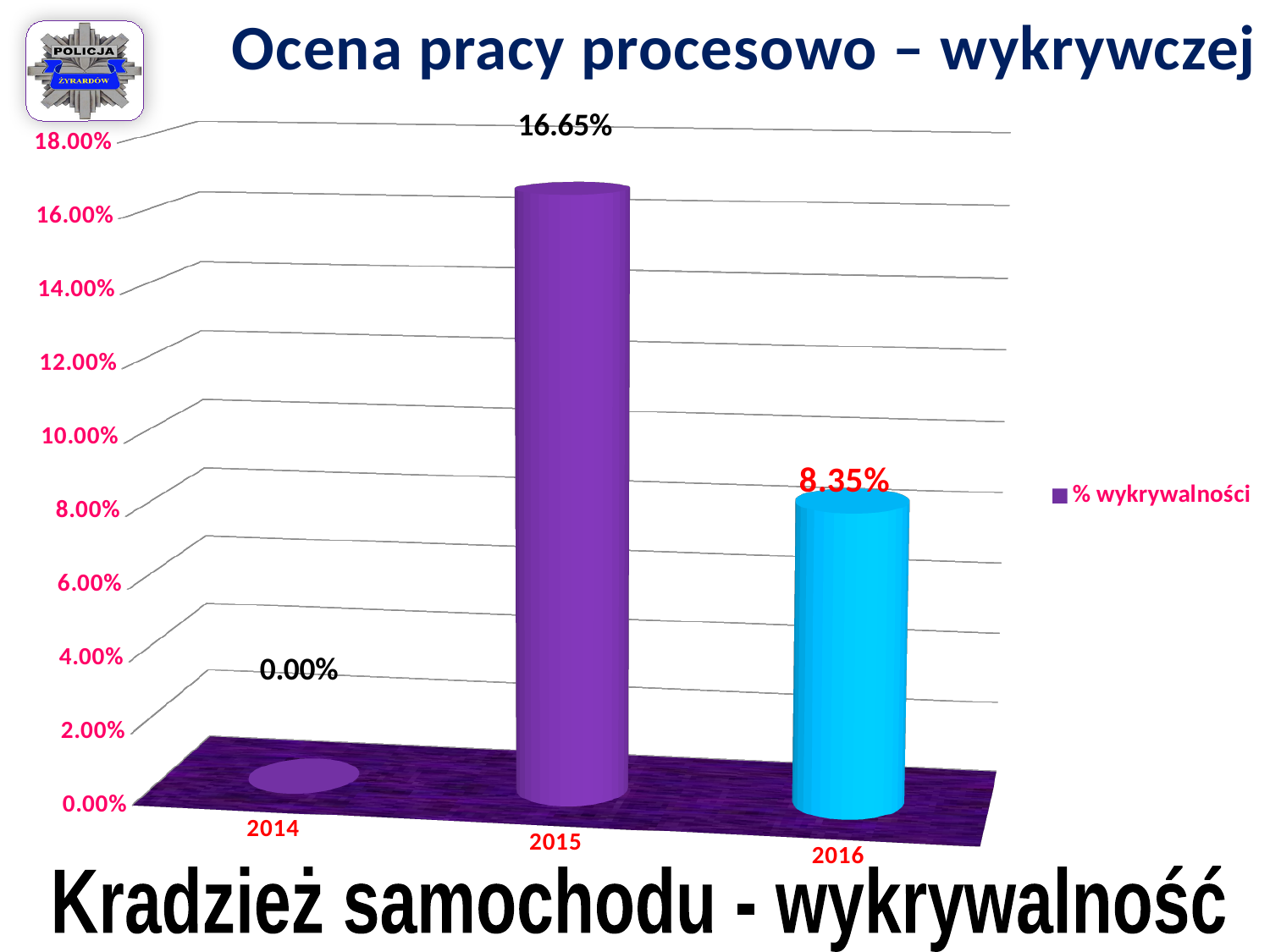
What is the value for 2014? 0.00% Which is larger, the value for 2015 or the value for 2016? 2015 What kind of chart is shown? bar chart What is the value for 2016? 8.35% What is the difference between the values for 2015 and 2016? 8.30% What is the value for 2015? 16.65% How many series does the legend list? 1 How many years are shown on the x axis? 3 What is the series name shown in the legend? % wykrywalności Is the value for 2016 greater or less than 10.00%? less Which year has the highest value? 2015 Which year has the lowest value? 2014